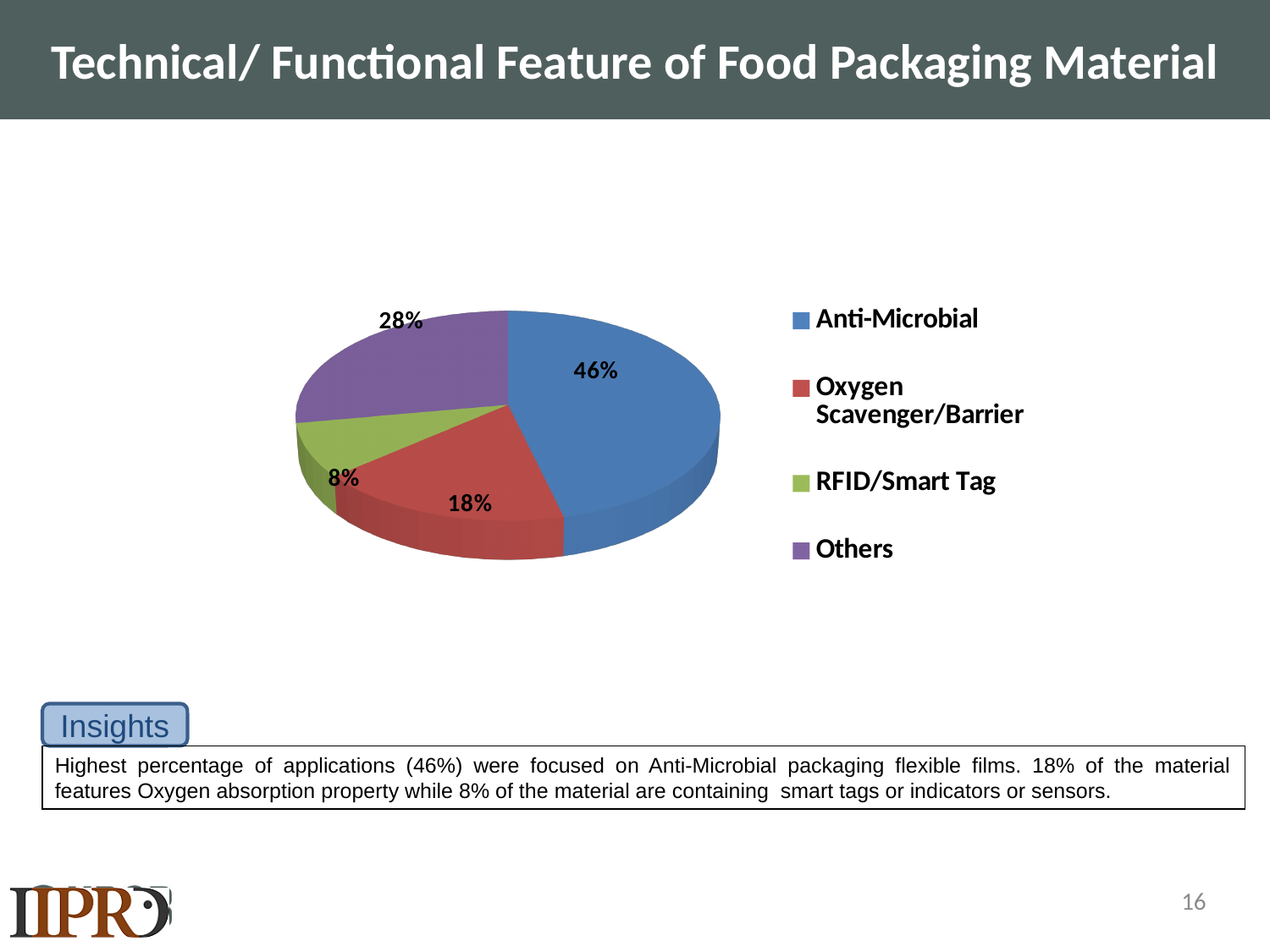
What is the difference in percentage points between Oxygen Scavenger/Barrier and RFID/Smart Tag? 10 Which category has the smallest slice of the pie? RFID/Smart Tag Which category has the largest slice of the pie? Anti-Microbial What is the value shown for Others? 28% What is the value shown for Oxygen Scavenger/Barrier? 18% What share of the pie does Anti-Microbial account for? 46% What is the difference in percentage points between Anti-Microbial and Others? 18 How many categories are shown in the pie chart? 4 Which is larger, the slice for Others or the slice for Oxygen Scavenger/Barrier? Others What colour is the slice for RFID/Smart Tag? Green What kind of chart is shown on the slide? Pie chart What is the value shown for RFID/Smart Tag? 8%